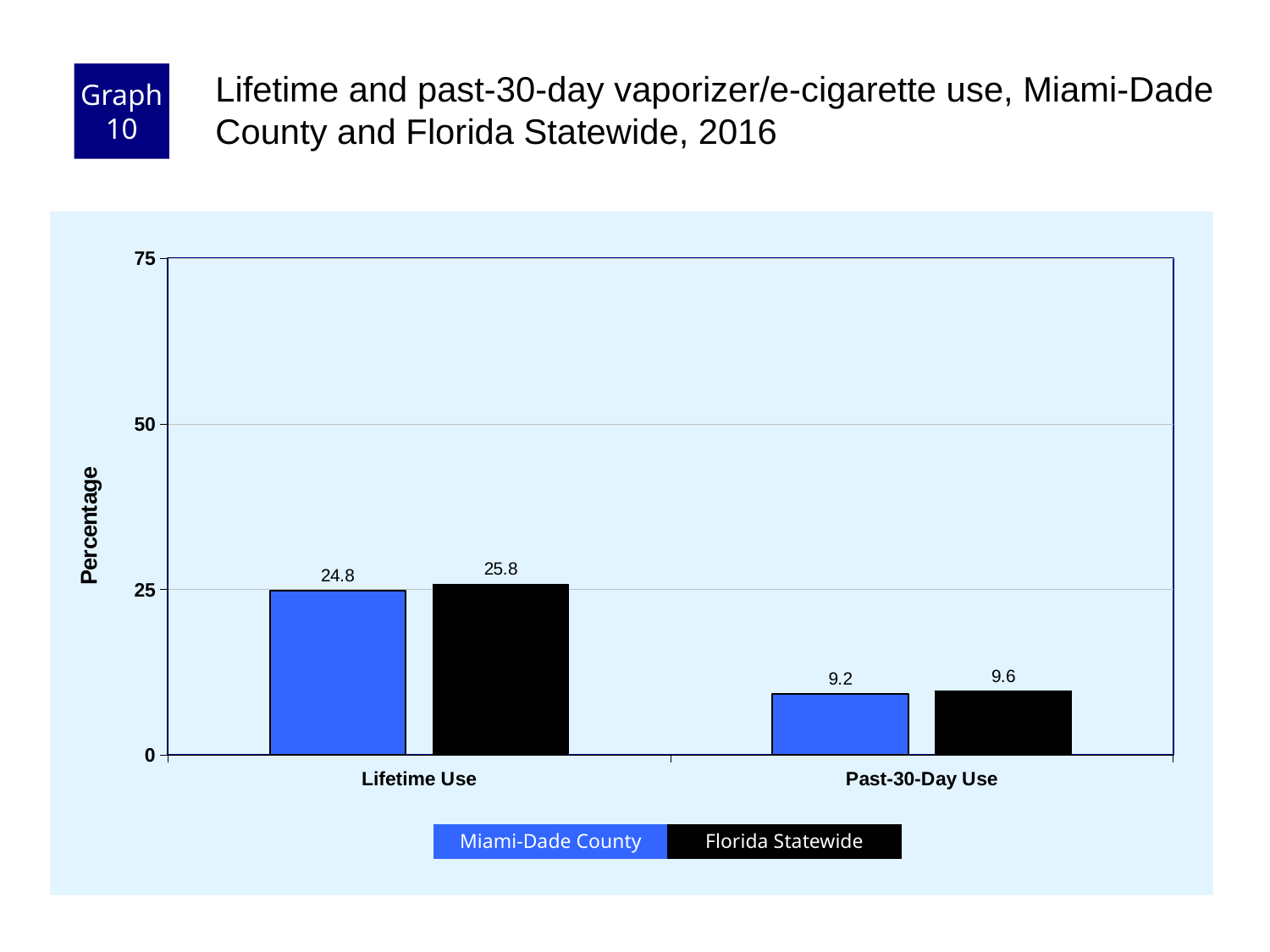
What is the difference between the Florida Statewide and Miami-Dade County values for Past-30-Day Use? 0.4 How many categories are shown on the x axis? 2 Which category has the lowest Miami-Dade County value? Past-30-Day Use Is the Miami-Dade County value for Lifetime Use greater or less than 50? less What is the Miami-Dade County value for Lifetime Use? 24.8 What is the Miami-Dade County value for Past-30-Day Use? 9.2 What is the Florida Statewide value for Lifetime Use? 25.8 Which category has the highest Florida Statewide value? Lifetime Use How many series does the legend list? 2 What is the Florida Statewide value for Past-30-Day Use? 9.6 What kind of chart is shown on the slide? bar chart What is the difference between the Florida Statewide and Miami-Dade County values for Lifetime Use? 1.0